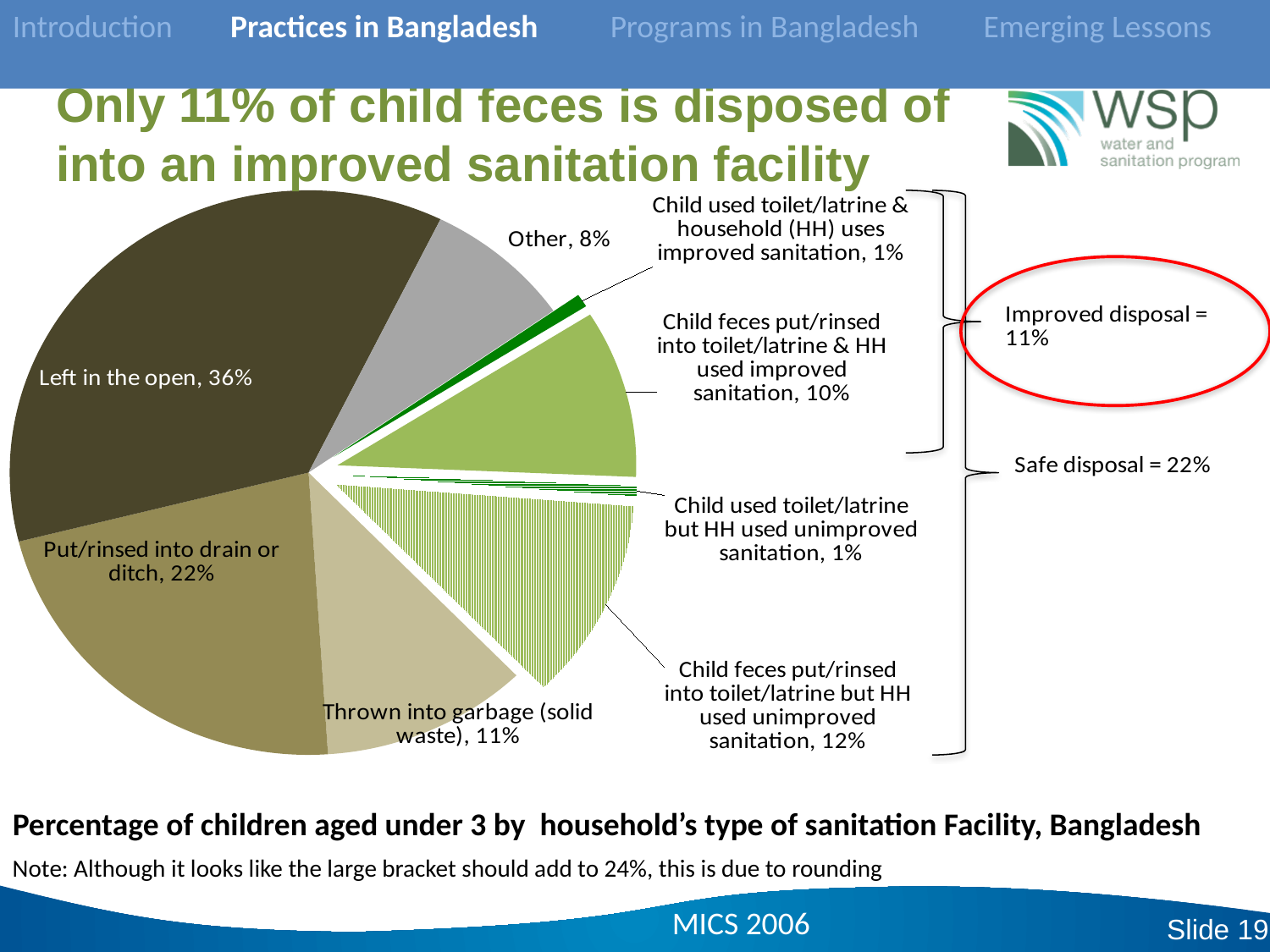
How many slices does the pie chart have? 8 According to the annotation on the slide, what percentage is 'Safe disposal'? 22% What kind of chart is shown on the slide? Pie chart What percentage of child feces is thrown into garbage (solid waste)? 11% What percentage of child feces is left in the open? 36% Which category has the largest slice of the pie chart? Left in the open What percentage is labelled 'Other' in the pie chart? 8% What is the difference between the 'Left in the open' share and the 'Put/rinsed into drain or ditch' share? 14% According to the annotation circled in red, what percentage is 'Improved disposal'? 11% What percentage of child feces is put/rinsed into a drain or ditch? 22% Which is larger: the share for 'Thrown into garbage (solid waste)' or the share for 'Other'? Thrown into garbage (solid waste) What percentage corresponds to child feces put/rinsed into toilet/latrine but HH used unimproved sanitation? 12%